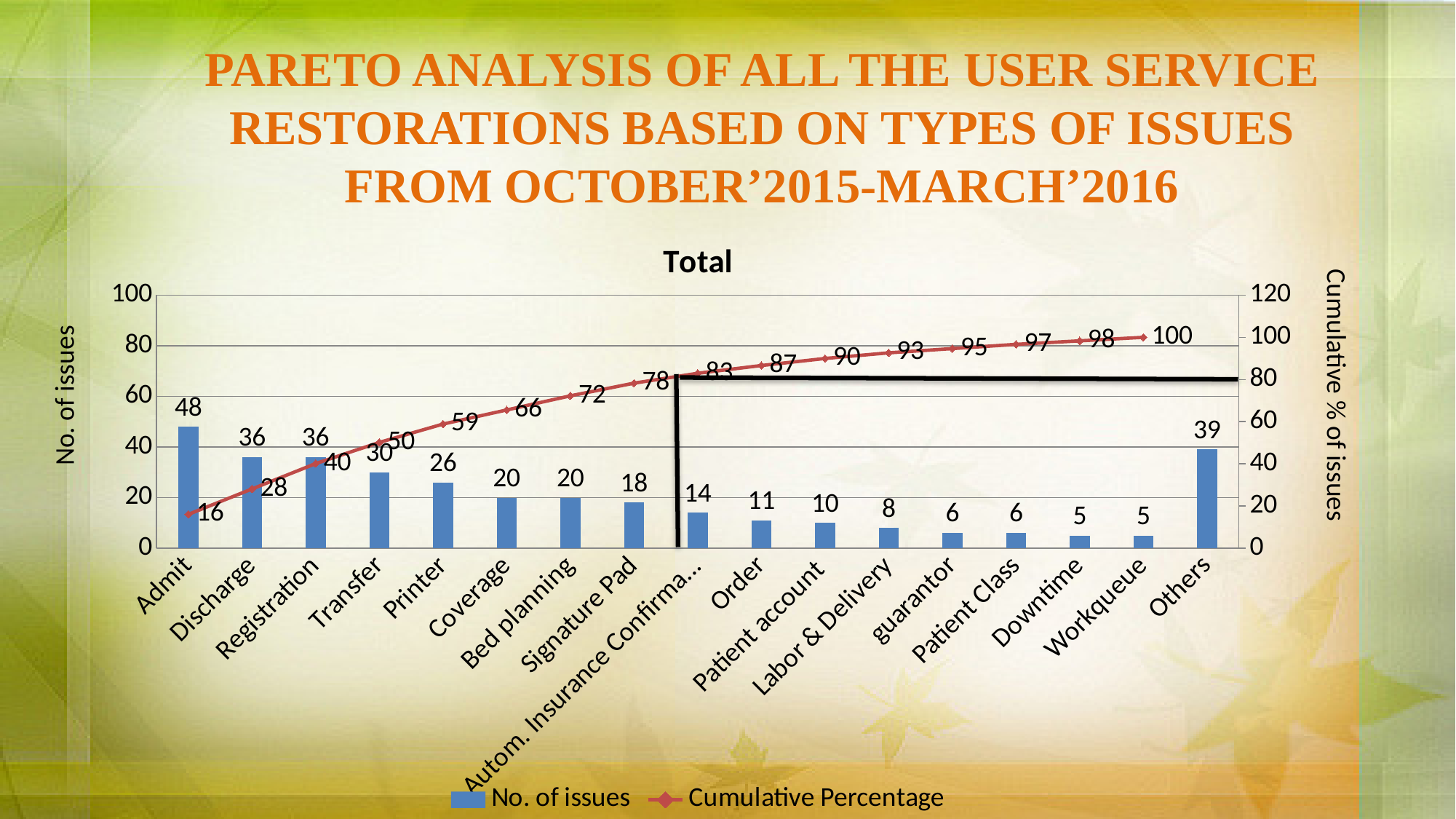
Which category has the highest number of issues? Admit What is the number of issues for Others? 39 What is the difference in number of issues between Admit and Discharge? 12 What kind of chart is this? Combined bar and line chart Does the Cumulative Percentage line rise or fall from Admit to Workqueue? Rises How many categories are shown on the x axis? 17 What is the title shown above the chart? Total What is the cumulative percentage at Signature Pad? 78 What is the number of issues for Printer? 26 How many series does the legend list? 2 What is the number of issues for Admit? 48 Which has more issues, Transfer or Others? Others